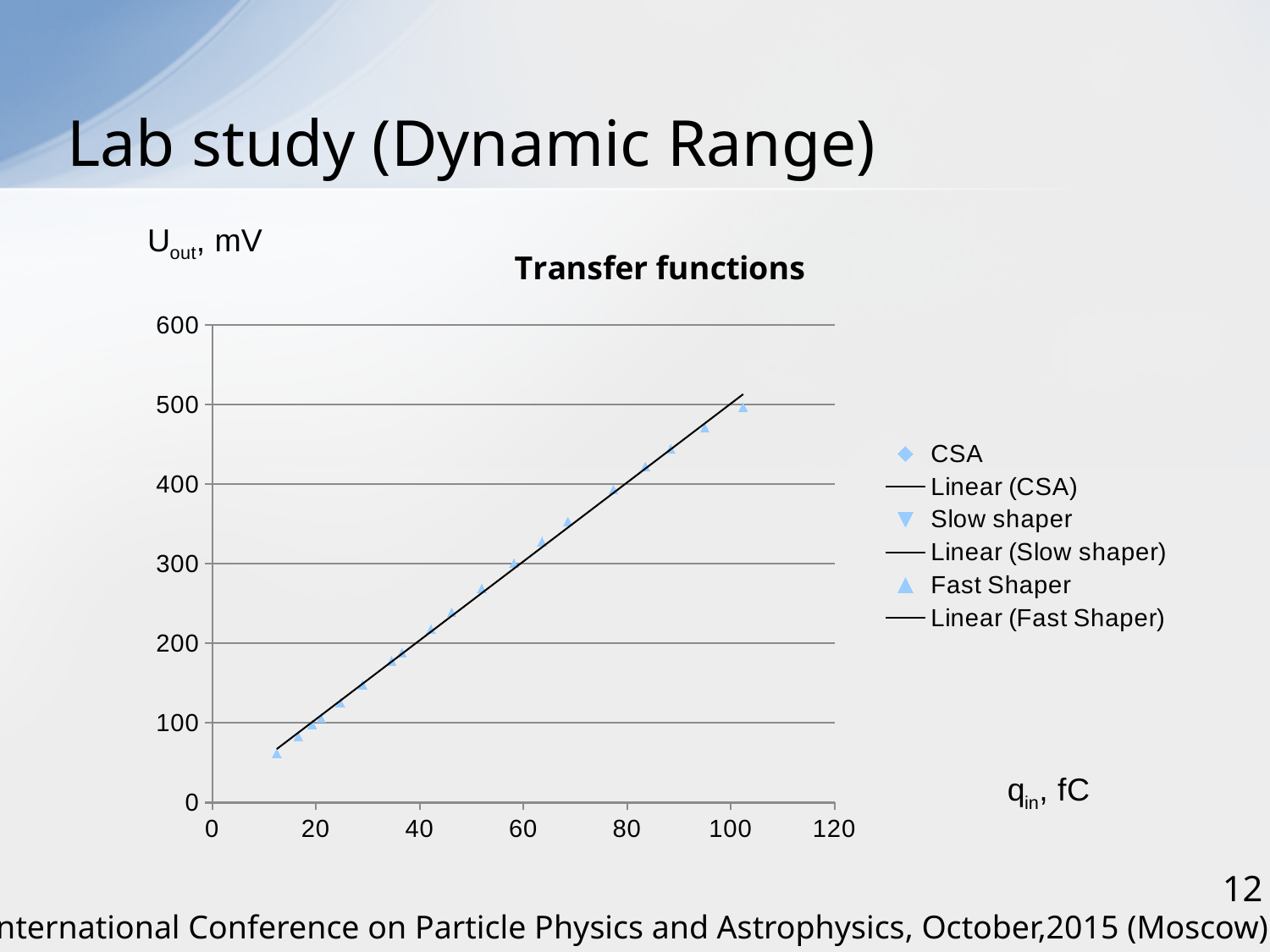
What kind of chart is shown on the slide? scatter chart Which legend entry is listed first? CSA Is the output value at an input of about 100 fC greater or less than 400 mV? greater Is the output value at the lowest plotted input (about 12 fC) greater or less than 100 mV? less How many entries does the chart legend list? 6 Do the plotted values rise or fall as the input charge increases along the x axis? rise What is the maximum value shown on the vertical axis? 600 Is the output value at an input of about 50 fC greater or less than 200 mV? greater What unit is given for the horizontal axis quantity q_in? fC What is the title of the chart? Transfer functions